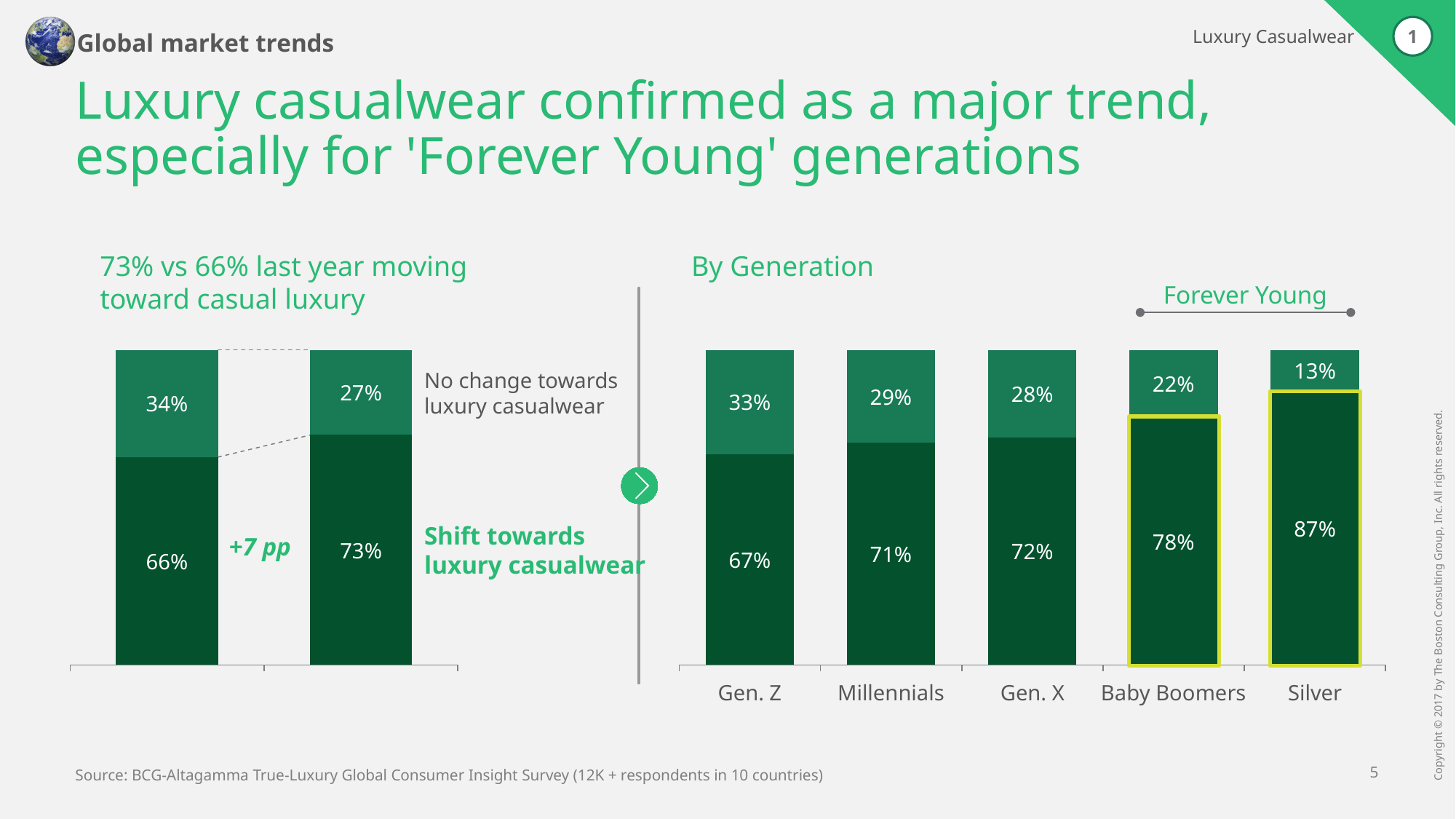
In the 'By Generation' chart, which generation has the lowest 'No change towards luxury casualwear' value? Silver In the left chart, what is the 'No change towards luxury casualwear' value for last year? 34% In the 'By Generation' chart, which is larger: the 'Shift towards luxury casualwear' value for Millennials or for Gen. X? Gen. X In the 'By Generation' chart, what is the difference between the 'Shift towards luxury casualwear' values for Baby Boomers and Gen. Z? 11 pp In the 'By Generation' chart, do the 'Shift towards luxury casualwear' values rise or fall from Gen. Z to Silver? rise In the 'By Generation' chart, what is the 'Shift towards luxury casualwear' value for Silver? 87% In the left chart, what is the 'Shift towards luxury casualwear' value for this year? 73% In the 'By Generation' chart, which generation has the highest 'Shift towards luxury casualwear' value? Silver What kind of chart is the 'By Generation' chart? stacked bar chart In the left chart, what is the change in the 'Shift towards luxury casualwear' value from last year to this year? +7 pp How many generations are shown in the 'By Generation' chart? 5 In the 'By Generation' chart, what is the 'No change towards luxury casualwear' value for Gen. Z? 33%